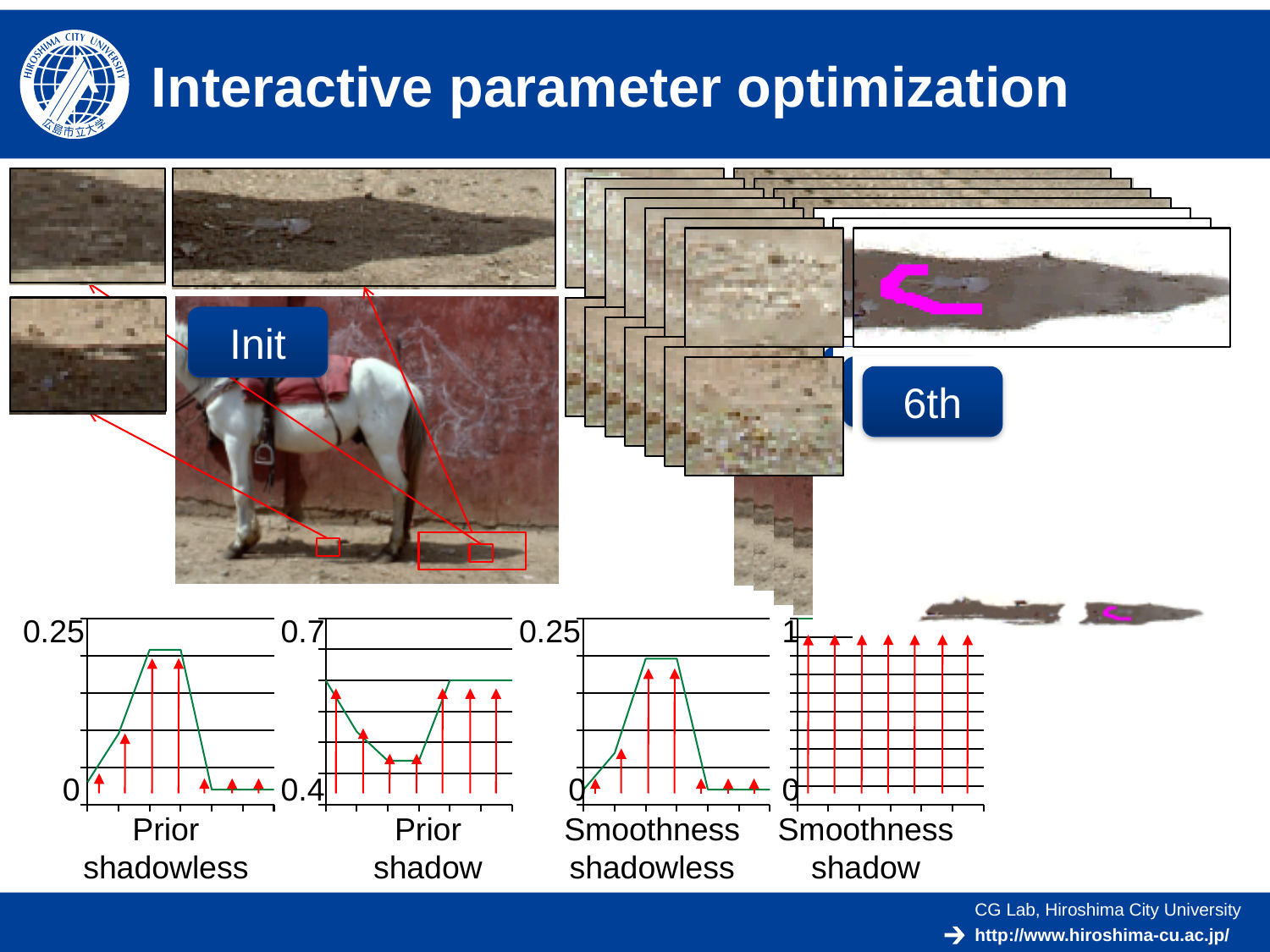
In the 'Prior shadowless' chart, is the highest value of the green curve greater or less than 0.25? less In the 'Smoothness shadow' chart, what is the top value labelled on the vertical axis? 1 How many small charts are shown along the bottom of the slide? 4 In the 'Prior shadowless' chart, does the green curve rise or fall from the first point to the middle points? rise In the 'Prior shadowless' chart, what is the top value labelled on the vertical axis? 0.25 What is the label under the rightmost chart at the bottom of the slide? Smoothness shadow In the 'Prior shadow' chart, what is the top value labelled on the vertical axis? 0.7 How many red arrows (data points) are drawn in the 'Smoothness shadowless' chart? 7 In the 'Prior shadow' chart, is the lowest value of the green curve greater or less than 0.4? greater What is the label under the leftmost chart at the bottom of the slide? Prior shadowless In the 'Prior shadow' chart, does the green curve fall or rise from the first point to the middle points? fall In the 'Prior shadow' chart, what is the bottom value labelled on the vertical axis? 0.4